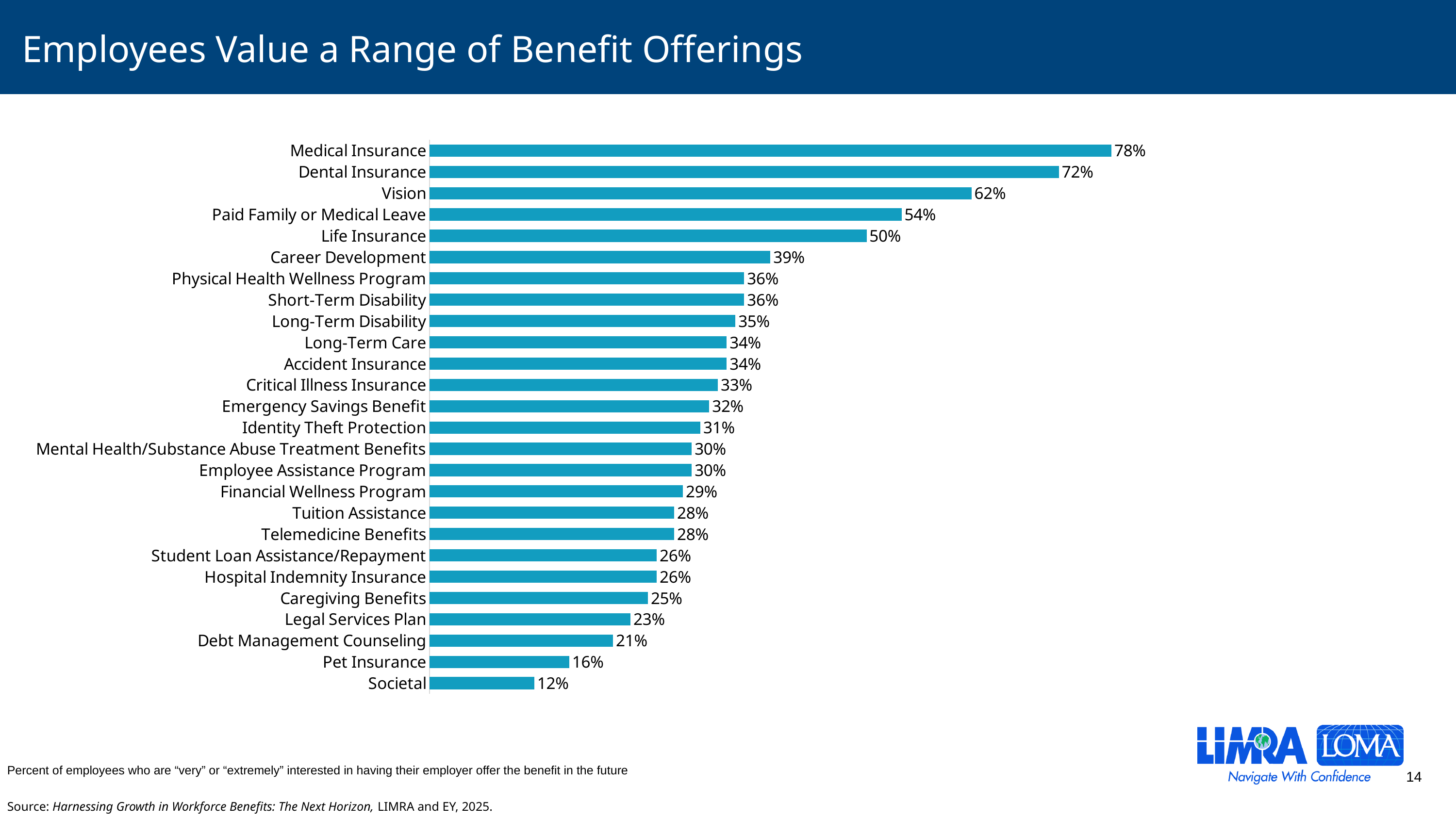
Which benefit has the highest value on the chart? Medical Insurance What is the difference between the values for Medical Insurance and Dental Insurance? 6% What is the value shown for Pet Insurance? 16% What is the title of the slide? Employees Value a Range of Benefit Offerings How many benefit categories are shown on the chart? 26 What is the difference between the values for Vision and Life Insurance? 12% Which is larger, the value for Legal Services Plan or the value for Caregiving Benefits? Caregiving Benefits What percentage of employees are very or extremely interested in Medical Insurance? 78% Which benefit has the lowest value on the chart? Societal Which is larger, the value for Paid Family or Medical Leave or the value for Career Development? Paid Family or Medical Leave What is the value shown for Career Development? 39% What kind of chart is shown on the slide? Bar chart